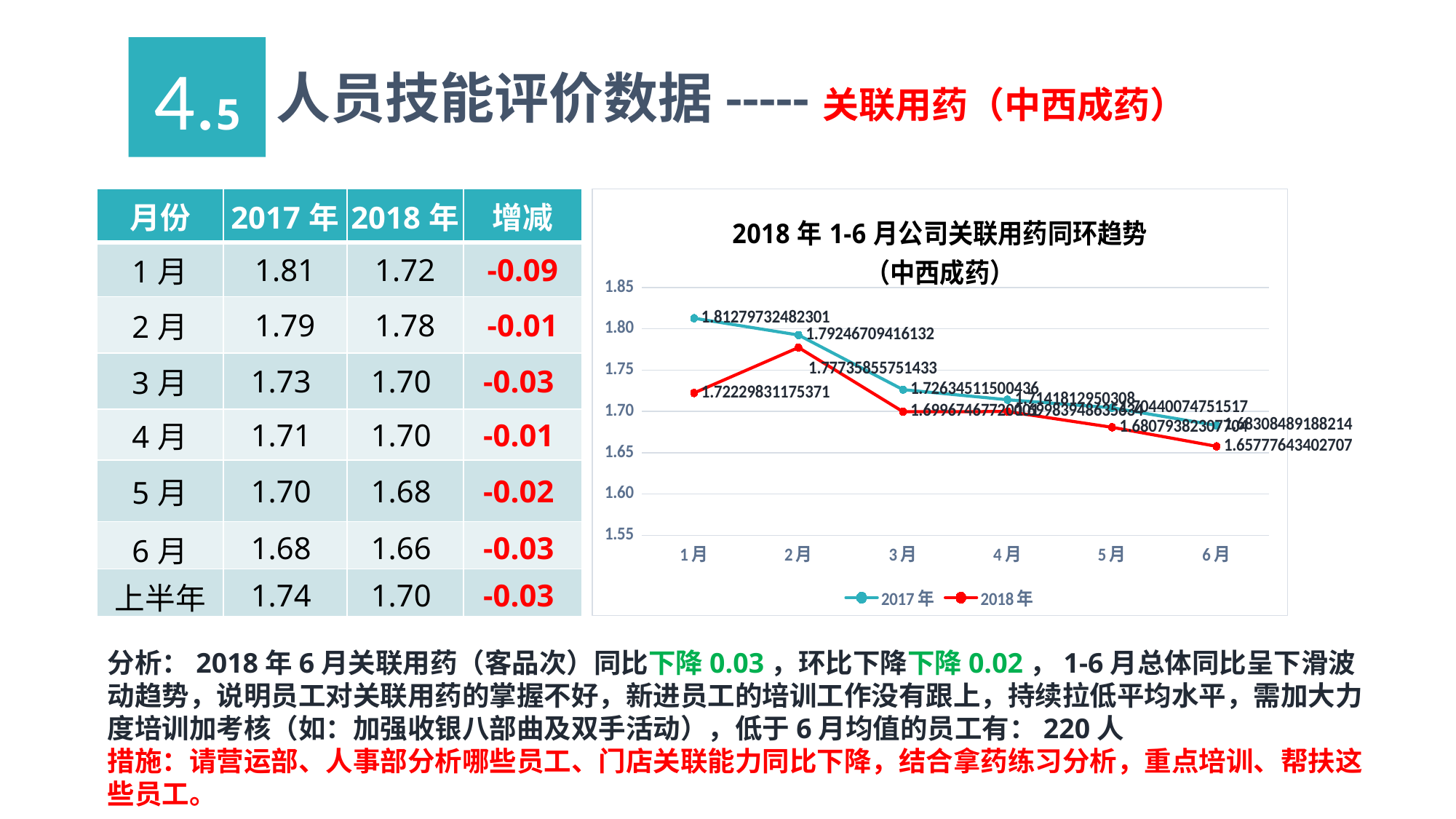
In 1月, which series has the larger value, 2017年 or 2018年? 2017年 What is the data label for 2017年 in 1月 on the chart? 1.81279732482301 What is the data label for 2018年 in 2月 on the chart? 1.77735855751433 Does the 2017年 series rise or fall from 1月 to 6月? fall How many months are plotted along the x axis of the chart? 6 What is the data label for 2018年 in 6月 on the chart? 1.65777643402707 What is the title of the chart? 2018年1-6月公司关联用药同环趋势（中西成药） How many series does the chart legend list? 2 What kind of chart is shown on the slide? line chart In which month is the 2017年 series highest? 1月 In which month is the 2018年 series lowest? 6月 Is the value for 2018年 in 6月 greater or less than 1.70? less